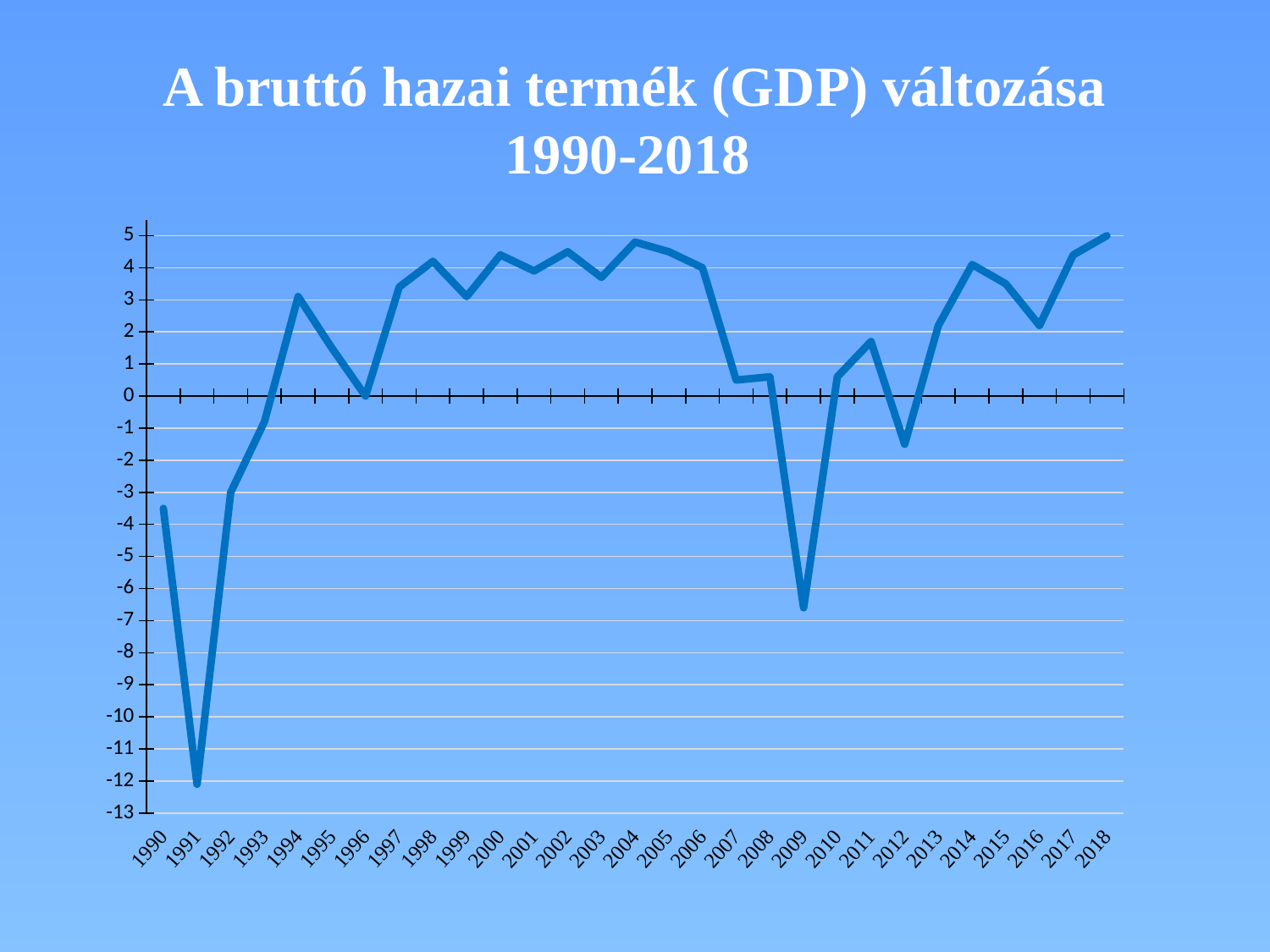
Is the value for 1991 greater or less than -10? less What kind of chart is shown on the slide? line chart Which year has the larger value, 2004 or 2012? 2004 Is the value for 2004 greater or less than 4? greater Is the value for 2009 greater or less than -5? less Which year has the lowest value on the chart? 1991 Which year has the larger value, 1991 or 2009? 2009 What is the title of the chart? A bruttó hazai termék (GDP) változása 1990-2018 How many years are plotted along the x axis? 29 Do the values rise or fall from 2006 to 2009? fall